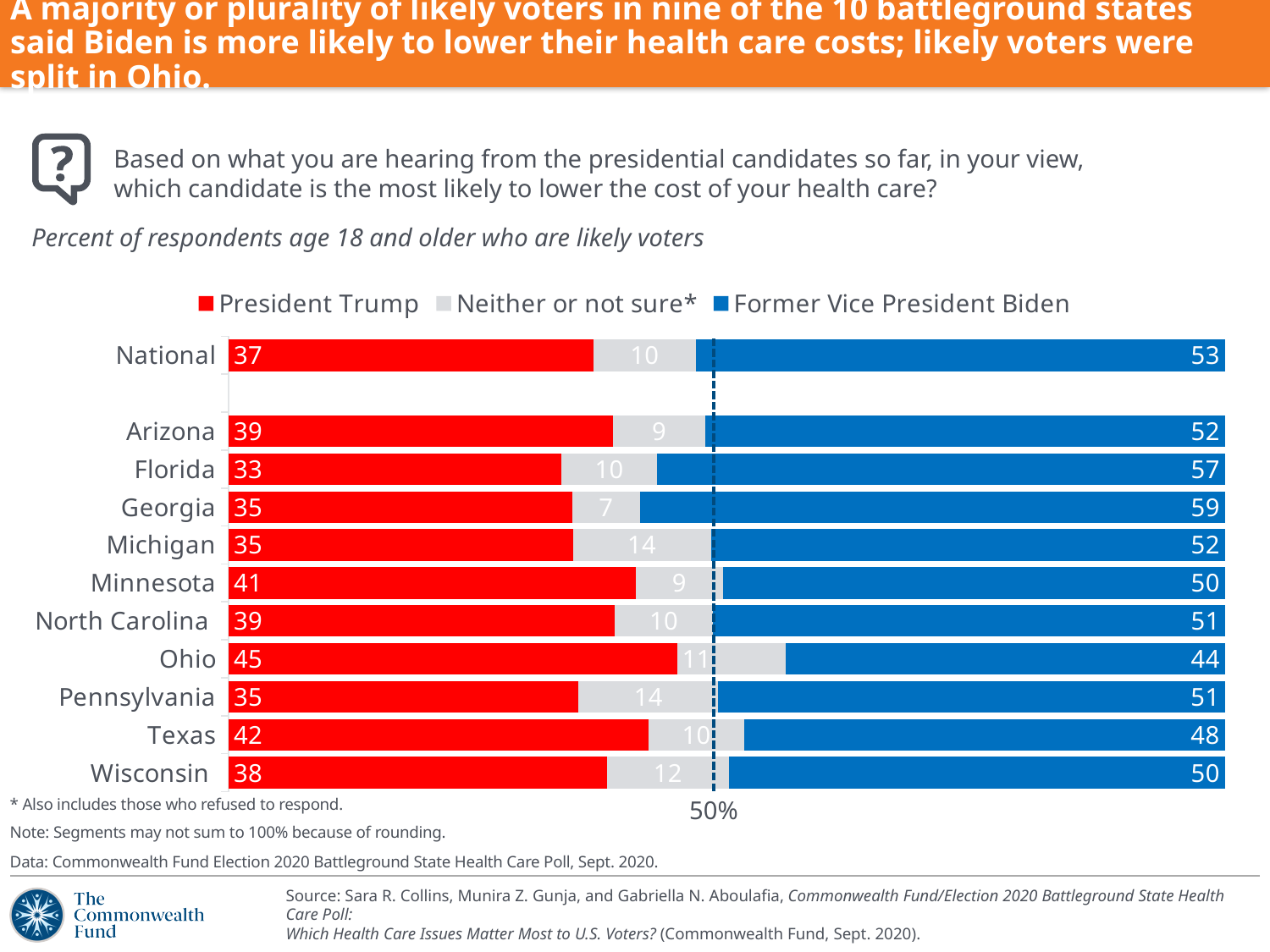
In Ohio, which is larger: the value for President Trump or the value for Former Vice President Biden? President Trump What is the value for Neither or not sure in Michigan? 14 How many series does the legend list? 3 What is the difference between the Biden and Trump values in Texas? 6 How many categories (rows) are shown in the chart? 11 Which colour represents Former Vice President Biden in the chart? Blue What kind of chart is shown on the slide? Stacked bar chart What is the value for President Trump in Ohio? 45 What percentage of likely voters in Florida said Former Vice President Biden is most likely to lower their health care costs? 57 Which state has the highest value for Former Vice President Biden? Georgia What is the total of the three segments for the Wisconsin bar? 100 Which category has the lowest value for President Trump? Florida